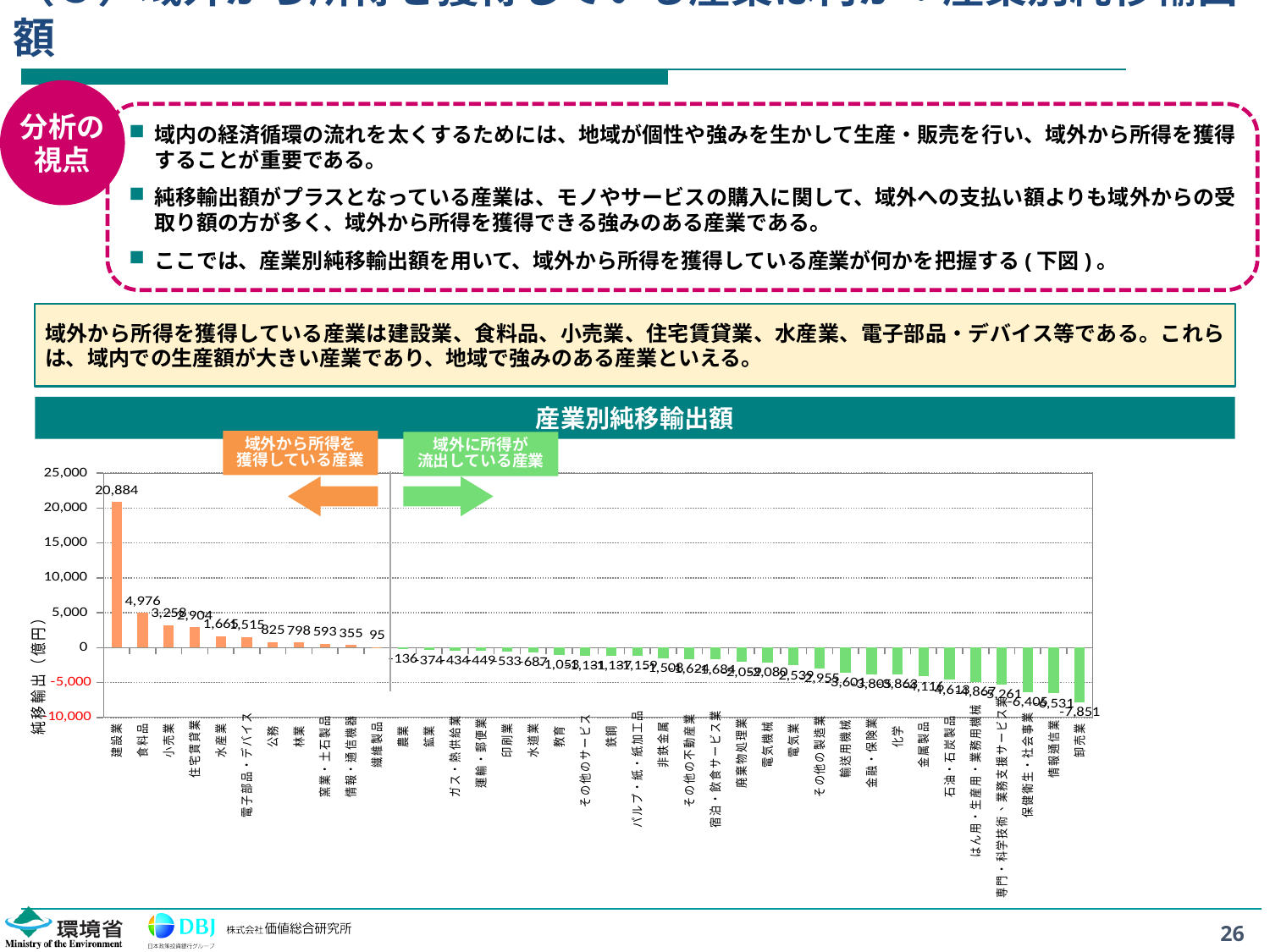
Which industry has the lowest 純移輸出 value in the chart? 卸売業 What is the difference between the 純移輸出 values of 建設業 and 食料品? 15,908 What is the 純移輸出 value for 卸売業? -7,851 Is the 純移輸出 value for 建設業 greater or less than 20,000? greater What is the title of the chart on the slide? 産業別純移輸出額 Which has the larger 純移輸出 value, 小売業 or 住宅賃貸業? 小売業 What kind of chart is shown under the title 産業別純移輸出額? bar chart How many industries have a positive (orange) 純移輸出 bar in the chart? 11 What is the 純移輸出 value for 食料品? 4,976 What is the 純移輸出 value for 建設業? 20,884 What is the 純移輸出 value for 水産業? 1,665 Which industry has the highest 純移輸出 value in the chart? 建設業